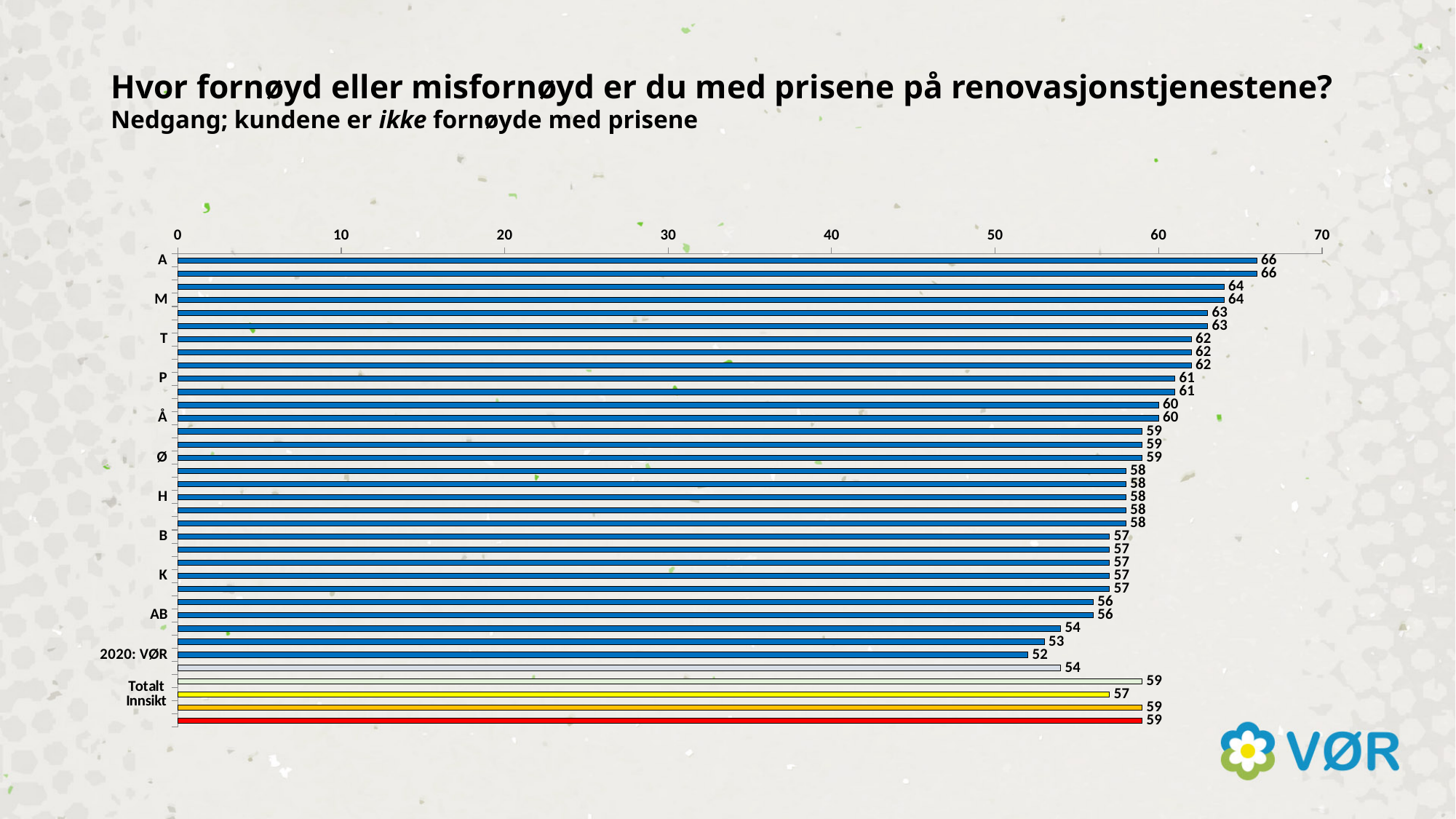
What is the value of the bar labelled A? 66 Do the blue bar values generally increase or decrease going from the top of the chart to the bottom? decrease What is the value of the red bar at the bottom of the chart? 59 What is the title of the chart on the slide? Hvor fornøyd eller misfornøyd er du med prisene på renovasjonstjenestene? What is the highest value shown on the chart? 66 Is the value for 2020: VØR greater or less than 60? less What is the lowest value shown on the chart? 52 What is the difference between the value for A and the value for 2020: VØR? 14 Is the value for A greater or less than 60? greater What is the value of the bar labelled 2020: VØR? 52 What kind of chart is shown on the slide? bar chart Which is larger, the value for A or the value for 2020: VØR? A